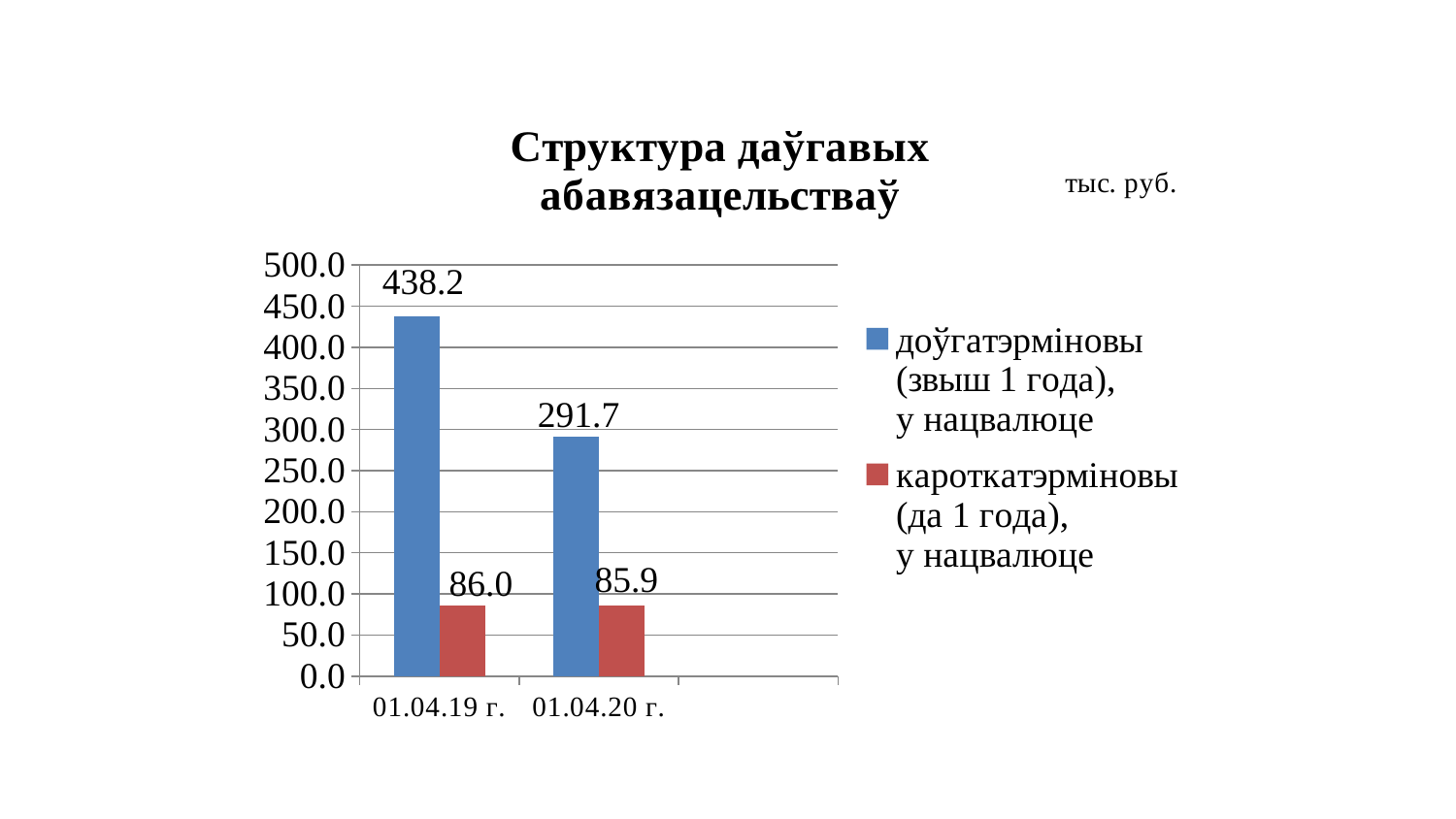
How many series does the legend list? 2 Is the long-term (доўгатэрміновы) value for 01.04.20 г. greater or less than 300.0? less What is the value of the long-term (доўгатэрміновы) series for 01.04.19 г.? 438.2 What is the value of the long-term (доўгатэрміновы) series for 01.04.20 г.? 291.7 What is the difference between the long-term and short-term values for 01.04.19 г.? 352.2 What is the value of the short-term (кароткатэрміновы) series for 01.04.19 г.? 86.0 What is the value of the short-term (кароткатэрміновы) series for 01.04.20 г.? 85.9 Which date has the highest value for the long-term (доўгатэрміновы) series? 01.04.19 г. By how much did the long-term (доўгатэрміновы) value decrease from 01.04.19 г. to 01.04.20 г.? 146.5 Which is larger for 01.04.20 г.: the long-term (доўгатэрміновы) value or the short-term (кароткатэрміновы) value? long-term (доўгатэрміновы) How many dates (categories) are shown on the x axis? 2 What type of chart is shown on the slide? bar chart